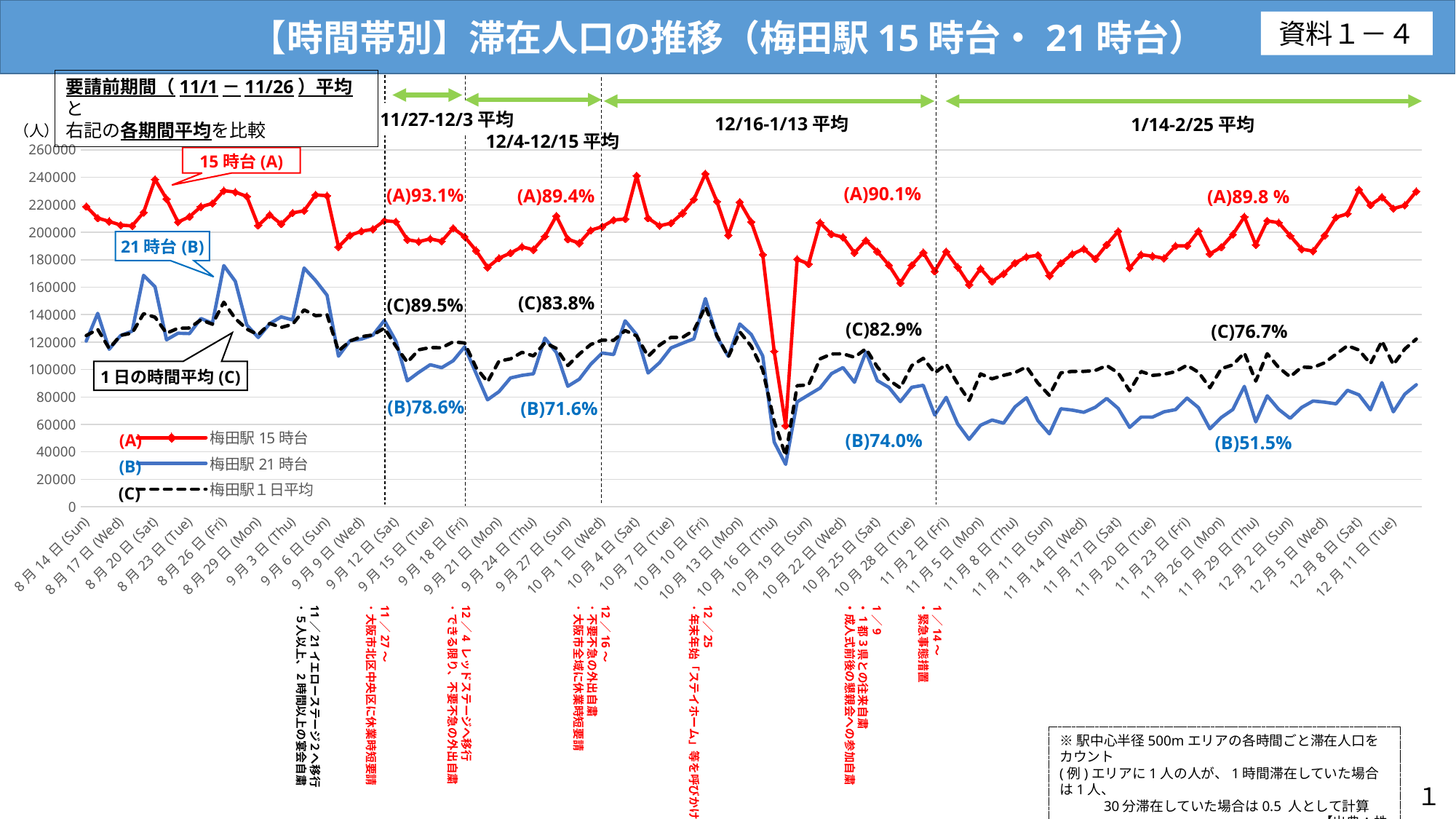
What legend label is given for series (A)? 梅田駅15時台 Among the four periods, which has the lowest (B) 21時台 percentage? 1/14-2/25 What kind of chart is shown on the slide? line chart Which is larger: the (C) percentage for 11/27-12/3 or the (C) percentage for 1/14-2/25? 11/27-12/3 (89.5%) What is the (C) 1日の時間平均 percentage shown for the 12/4-12/15 period? 83.8% In the 12/16-1/13 period, what is the difference between the (A) percentage and the (B) percentage? 16.1 percentage points What is the (B) 21時台 percentage shown for the 1/14-2/25 period? 51.5% What is the (B) 21時台 percentage shown for the 12/4-12/15 period? 71.6% How many series does the chart legend list? 3 What is the (A) 15時台 percentage shown for the 11/27-12/3 period? 93.1% Among the four periods, which has the highest (A) 15時台 percentage? 11/27-12/3 Do the (C) percentages rise or fall across the four periods from 11/27-12/3 to 1/14-2/25? fall